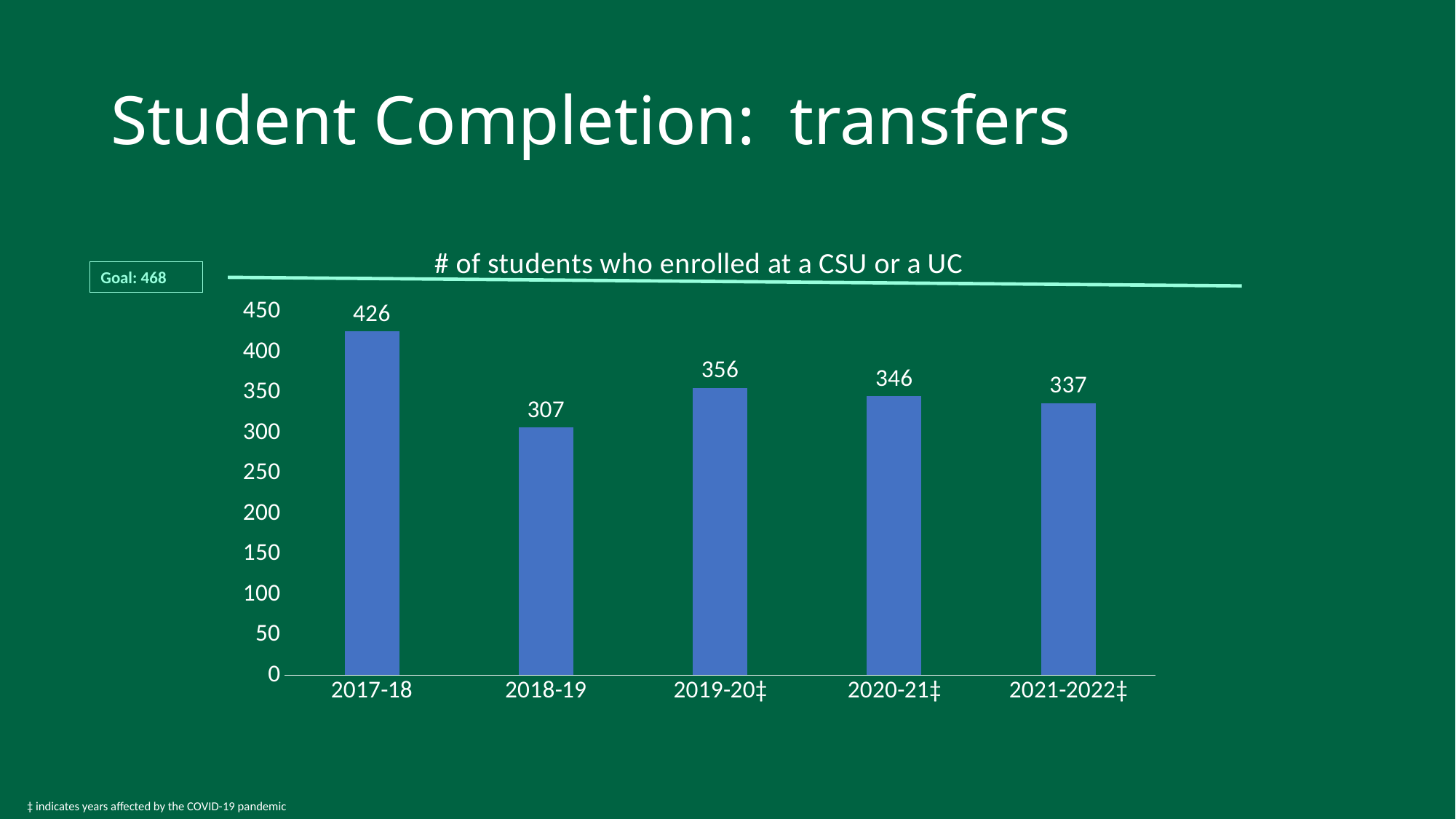
Which year has the lowest number of students who enrolled at a CSU or a UC? 2018-19 What is the value for 2021-2022‡? 337 What is the difference between the values for 2019-20‡ and 2020-21‡? 10 What is the difference between the values for 2017-18 and 2018-19? 119 What is the goal value shown next to the chart? 468 What is the value for 2018-19? 307 What is the value for 2019-20‡? 356 Which is larger, the value for 2020-21‡ or the value for 2021-2022‡? 2020-21‡ How many years are shown on the chart? 5 What is the value for 2017-18? 426 Which year has the highest number of students who enrolled at a CSU or a UC? 2017-18 What kind of chart is shown on the slide? Bar chart